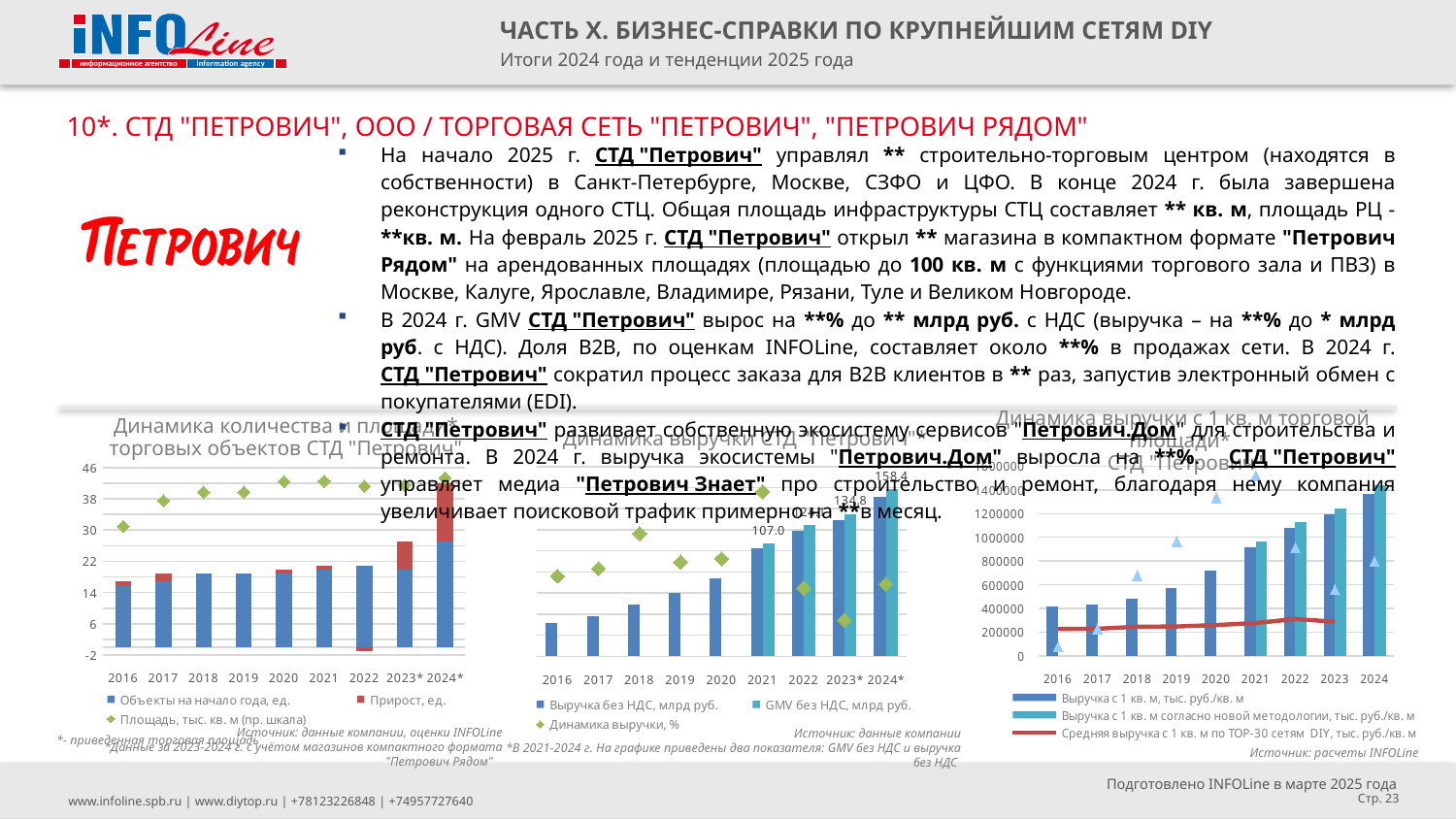
In the middle chart ("Динамика выручки СТД "Петрович""), what value is labelled for 2023*? 134.8 How many series does the legend of the left chart ("Динамика количества и площади торговых объектов") list? 3 In the middle chart ("Динамика выручки СТД "Петрович""), what is the difference between the labelled values for 2024* and 2023*? 23.6 How many series does the legend of the right chart ("Динамика выручки с 1 кв. м торговой площади") list? 3 In the left chart ("Динамика количества и площади торговых объектов"), is the value of "Объекты на начало года, ед." for 2024* greater or less than 22? greater In the middle chart ("Динамика выручки СТД "Петрович""), what value is labelled for 2024*? 158.4 In the right chart ("Динамика выручки с 1 кв. м торговой площади"), is the value of "Выручка с 1 кв. м, тыс. руб./кв. м" for 2024 greater or less than 1200000? greater In the right chart ("Динамика выручки с 1 кв. м торговой площади"), is the value of "Выручка с 1 кв. м, тыс. руб./кв. м" for 2016 greater or less than 600000? less In the right chart ("Динамика выручки с 1 кв. м торговой площади"), which year has the highest value of "Выручка с 1 кв. м, тыс. руб./кв. м"? 2024 How many years are shown on the x axis of the left chart ("Динамика количества и площади торговых объектов")? 9 In the middle chart ("Динамика выручки СТД "Петрович""), what value is labelled for 2022? 124.1 What kind of chart is the middle chart, "Динамика выручки СТД "Петрович""? Combination bar and line chart